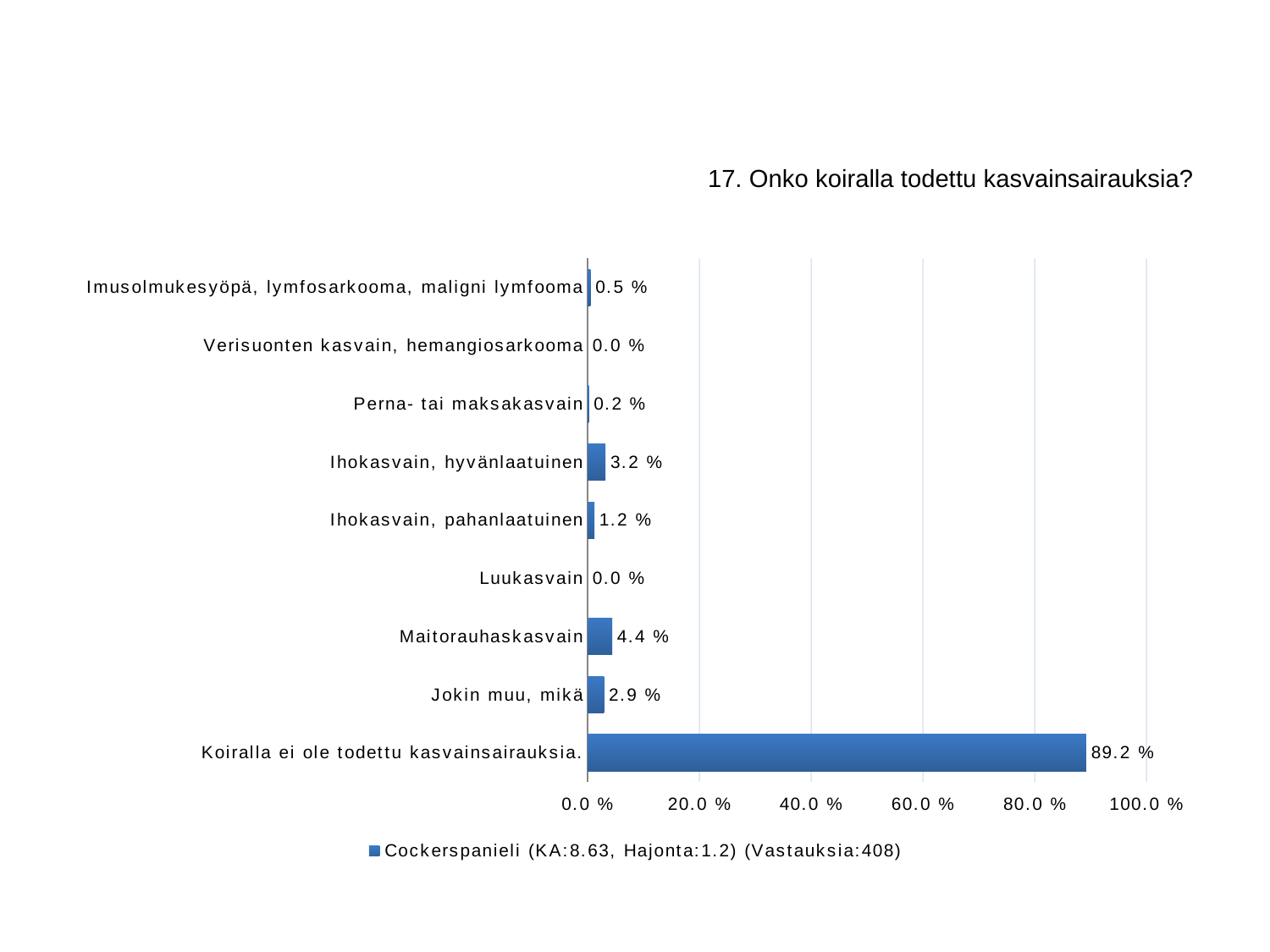
What is the value for "Perna- tai maksakasvain"? 0.2 % What kind of chart is shown on the slide? bar chart What is the value for "Ihokasvain, hyvänlaatuinen"? 3.2 % Which category has the highest value? Koiralla ei ole todettu kasvainsairauksia. What is the value for "Maitorauhaskasvain"? 4.4 % What is the title of the chart? 17. Onko koiralla todettu kasvainsairauksia? Is the value for "Koiralla ei ole todettu kasvainsairauksia." greater or less than 80.0 %? greater How many series does the legend list? 1 Which is larger, the value for "Ihokasvain, hyvänlaatuinen" or "Ihokasvain, pahanlaatuinen"? Ihokasvain, hyvänlaatuinen What is the difference between the values for "Maitorauhaskasvain" and "Jokin muu, mikä"? 1.5 % What is the value for "Koiralla ei ole todettu kasvainsairauksia."? 89.2 % How many categories are shown on the chart? 9